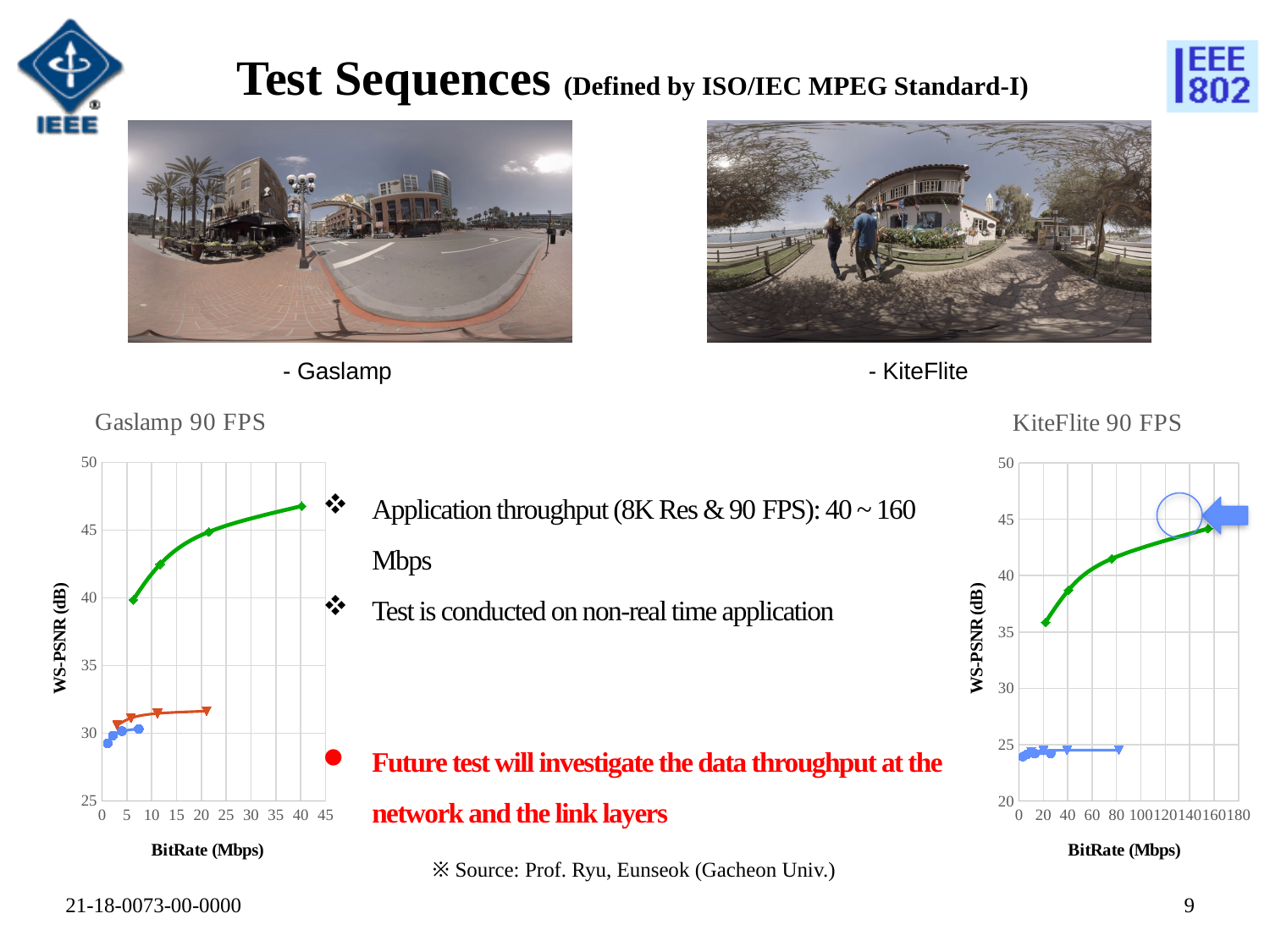
In the Gaslamp 90 FPS chart, is the highest point of the green line greater or less than 45? greater In the KiteFlite 90 FPS chart, does the green line rise or fall as BitRate increases? rise In the Gaslamp 90 FPS chart, does the green line rise or fall as BitRate increases? rise How many lines are plotted in the KiteFlite 90 FPS chart? 3 In the KiteFlite 90 FPS chart, are the values of the blue line greater or less than 30? less What is the x-axis title of the KiteFlite 90 FPS chart? BitRate (Mbps) In the Gaslamp 90 FPS chart, are the values of the orange line greater or less than 35? less What is the y-axis title of the Gaslamp 90 FPS chart? WS-PSNR (dB) What type of chart is the Gaslamp 90 FPS chart? line chart What type of chart is the KiteFlite 90 FPS chart? line chart How many lines are plotted in the Gaslamp 90 FPS chart? 3